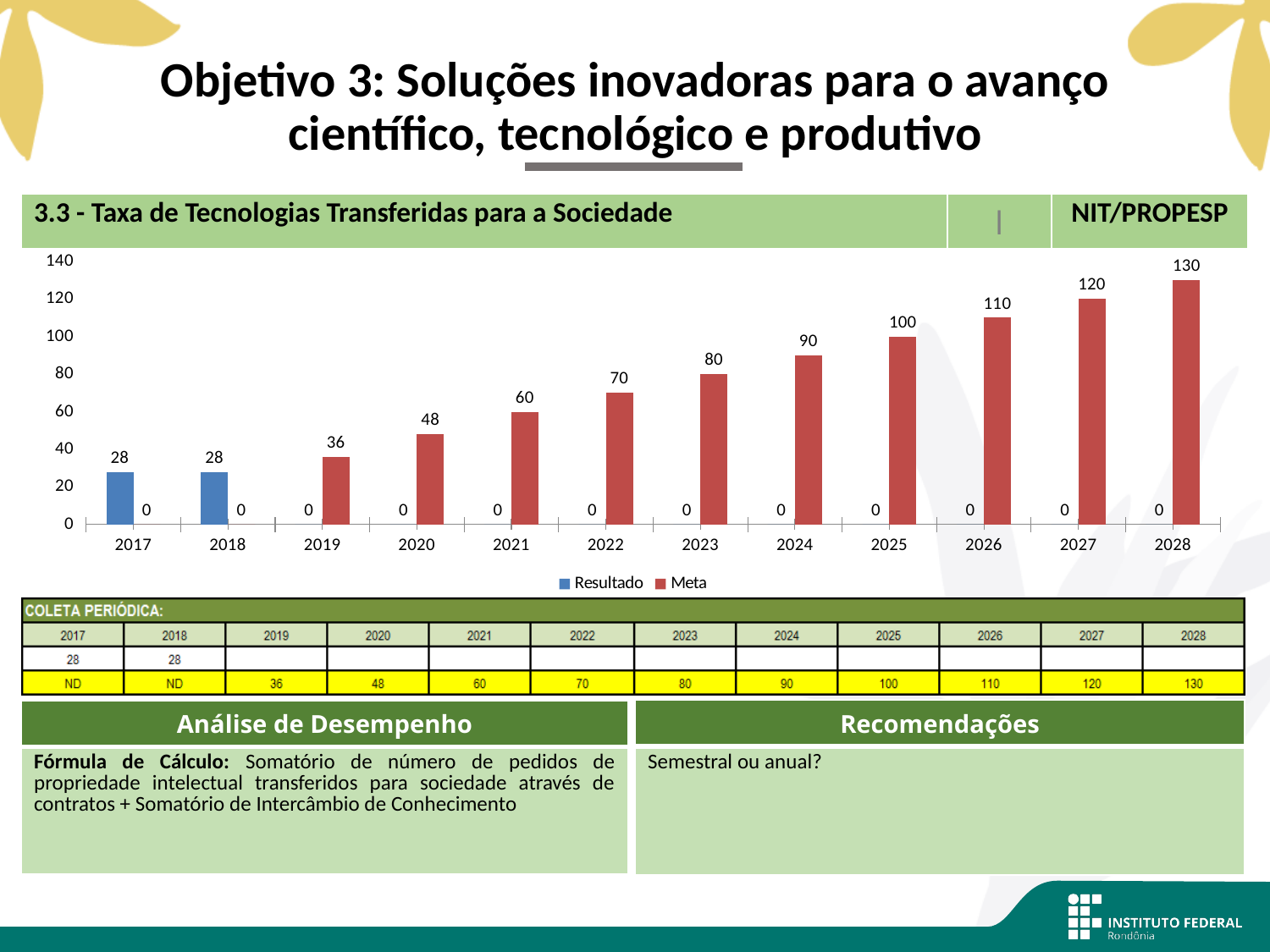
What is the difference between the Meta values for 2024 and 2023? 10 What kind of chart is shown? Bar chart What is the Meta value for 2019? 36 Do the Meta values rise or fall from 2019 to 2028? Rise Which is larger, the Meta value for 2020 or the Resultado value for 2018? Meta for 2020 Which year has the highest Meta value? 2028 What is the Resultado value for 2017? 28 How many years are shown on the x axis? 12 What is the difference between the Meta values for 2028 and 2019? 94 What is the Meta value for 2021? 60 What is the Meta value for 2028? 130 How many series does the legend list? 2